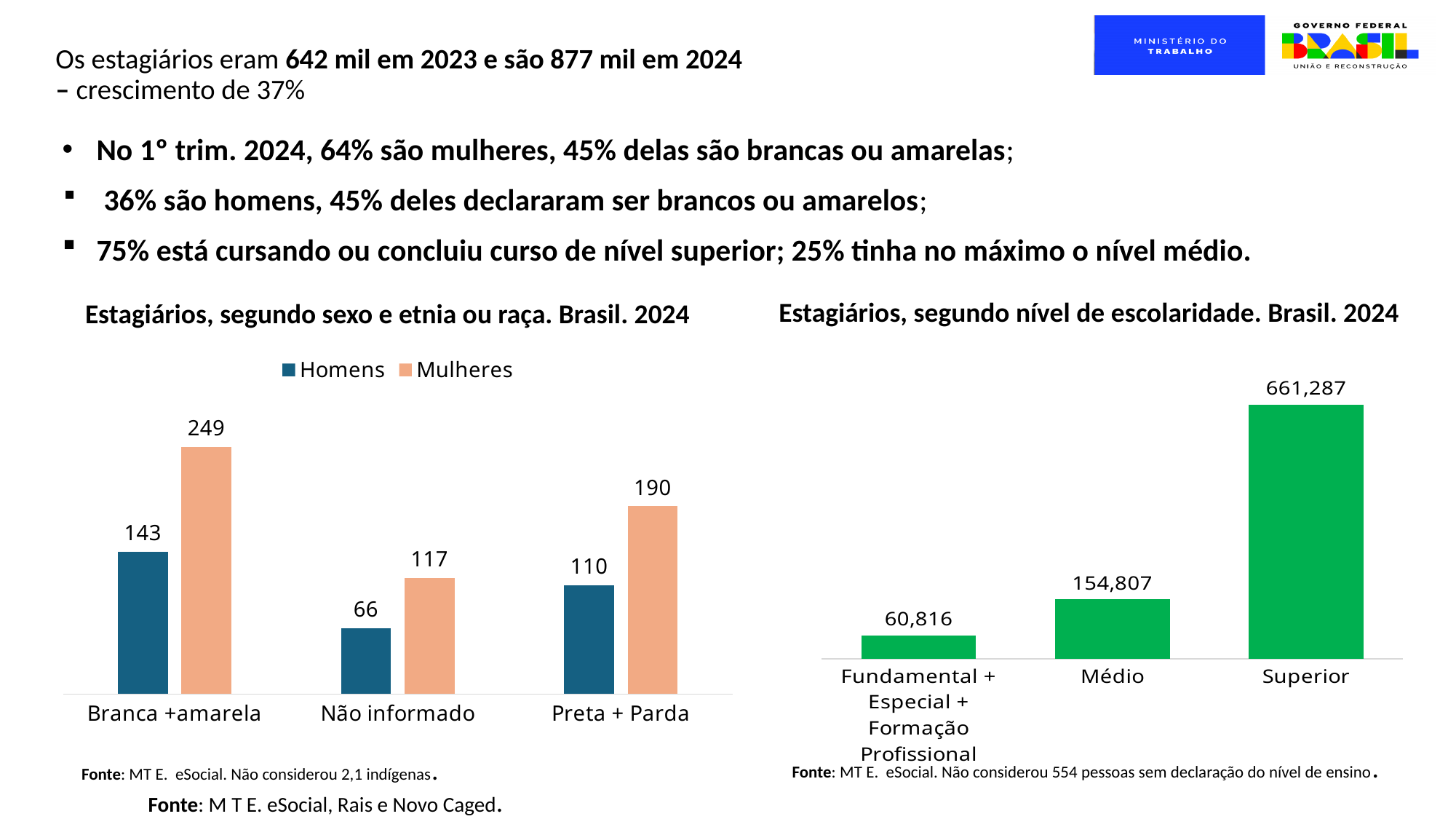
How many categories are shown in the chart 'Estagiários, segundo nível de escolaridade. Brasil. 2024'? 3 In the chart 'Estagiários, segundo nível de escolaridade. Brasil. 2024', what is the value for Superior? 661,287 In the chart 'Estagiários, segundo nível de escolaridade. Brasil. 2024', what is the difference between Superior and Médio? 506,480 In the chart 'Estagiários, segundo sexo e etnia ou raça. Brasil. 2024', what is the value for Homens in the Não informado category? 66 In the chart 'Estagiários, segundo sexo e etnia ou raça. Brasil. 2024', what is the difference between Mulheres and Homens in the Branca +amarela category? 106 In the chart 'Estagiários, segundo sexo e etnia ou raça. Brasil. 2024', what is the value for Mulheres in the Branca +amarela category? 249 In the chart 'Estagiários, segundo sexo e etnia ou raça. Brasil. 2024', which is larger: Homens in Preta + Parda or Mulheres in Não informado? Mulheres in Não informado How many series does the legend list in the chart 'Estagiários, segundo sexo e etnia ou raça. Brasil. 2024'? 2 In the chart 'Estagiários, segundo sexo e etnia ou raça. Brasil. 2024', what is the value for Mulheres in the Preta + Parda category? 190 In the chart 'Estagiários, segundo sexo e etnia ou raça. Brasil. 2024', which category has the highest value for Homens? Branca +amarela What kind of chart is 'Estagiários, segundo nível de escolaridade. Brasil. 2024'? Bar chart In the chart 'Estagiários, segundo nível de escolaridade. Brasil. 2024', which category has the lowest value? Fundamental + Especial + Formação Profissional